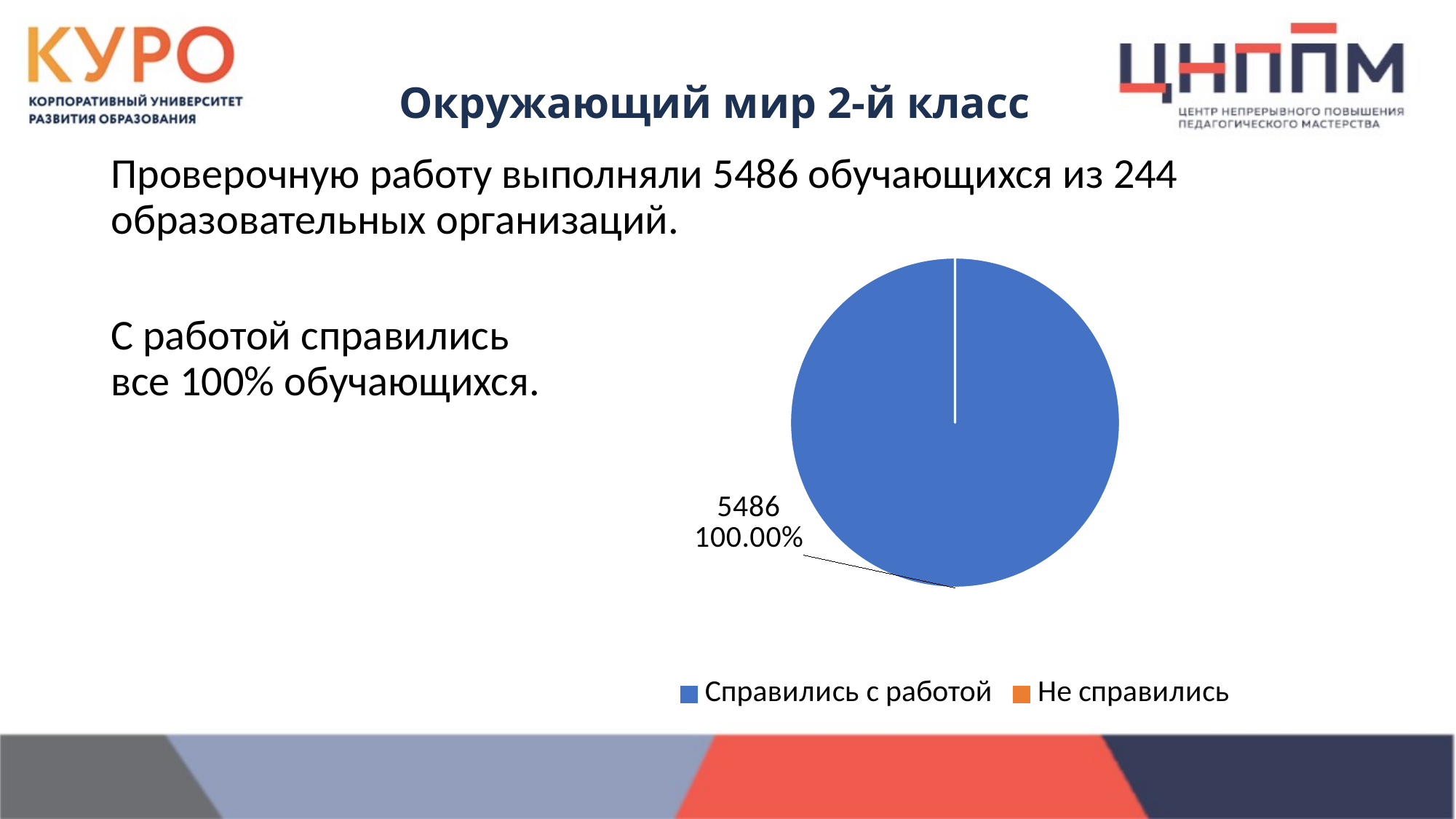
What kind of chart is shown on the slide? pie chart What value is printed on the slice for "Справились с работой"? 5486 Is the value for "Справились с работой" greater or less than 5000? greater Which category has the largest slice in the pie chart? Справились с работой How many entries does the chart legend list? 2 Which category has the smallest share in the pie chart? Не справились Which is larger in the pie chart: "Справились с работой" or "Не справились"? Справились с работой What colour does the legend assign to "Не справились"? orange What colour is the "Справились с работой" slice in the pie chart? blue What share of the pie does the "Справились с работой" slice represent, as printed on the chart? 100.00%